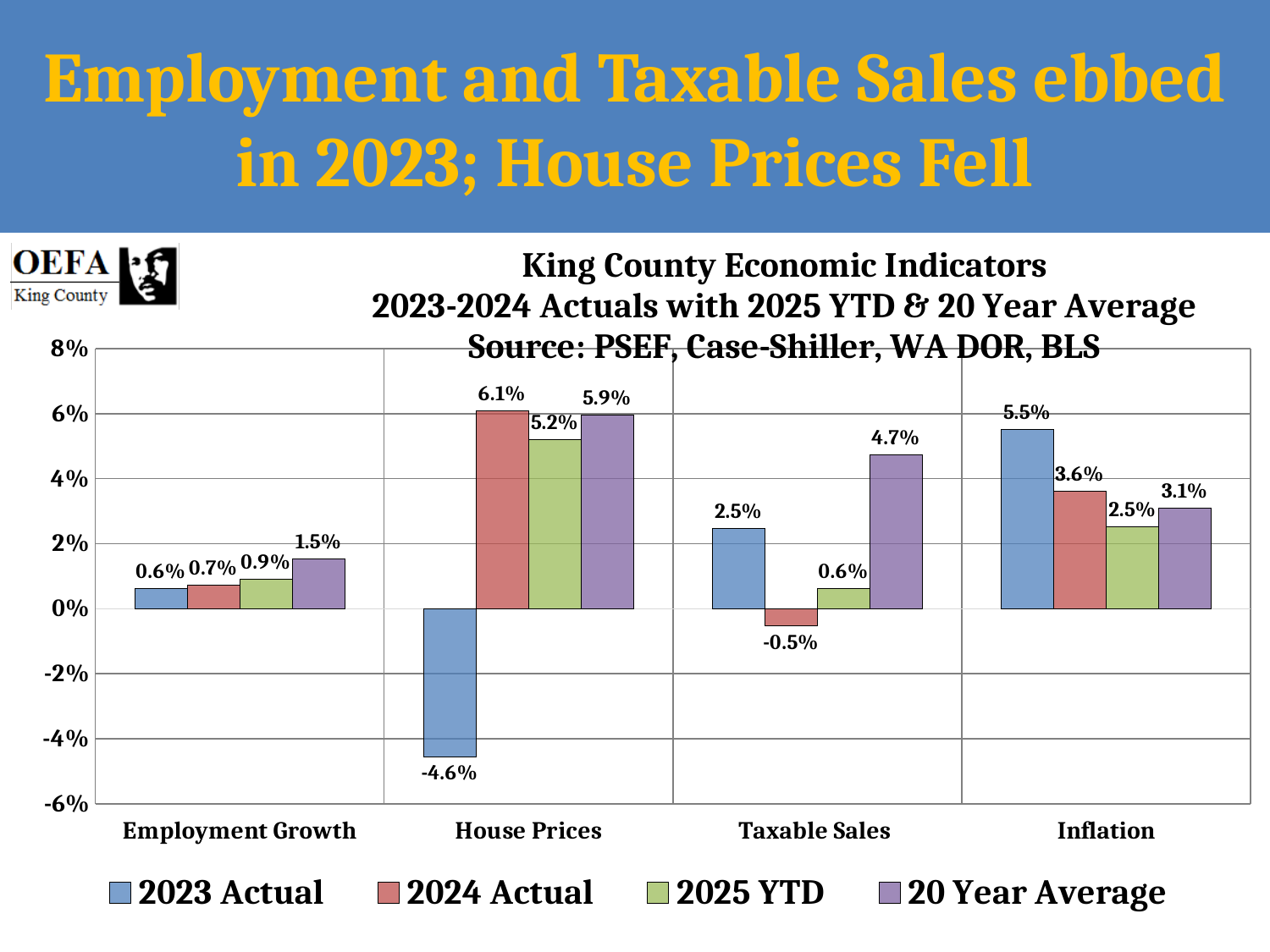
What is the 2025 YTD value for Inflation? 2.5% What is the 2023 Actual value for House Prices? -4.6% Which is larger for Taxable Sales: the 2023 Actual value or the 2025 YTD value? 2023 Actual Which series is shown in purple in the legend? 20 Year Average What is the 20 Year Average value for Taxable Sales? 4.7% How many categories are shown on the x axis? 4 Which category has the highest 2024 Actual value? House Prices What is the difference between the 2023 Actual and 2024 Actual values for Inflation? 1.9% Which category has the lowest 2023 Actual value? House Prices What is the 2024 Actual value for Employment Growth? 0.7% What kind of chart is shown on the slide? Bar chart How many series does the legend list? 4